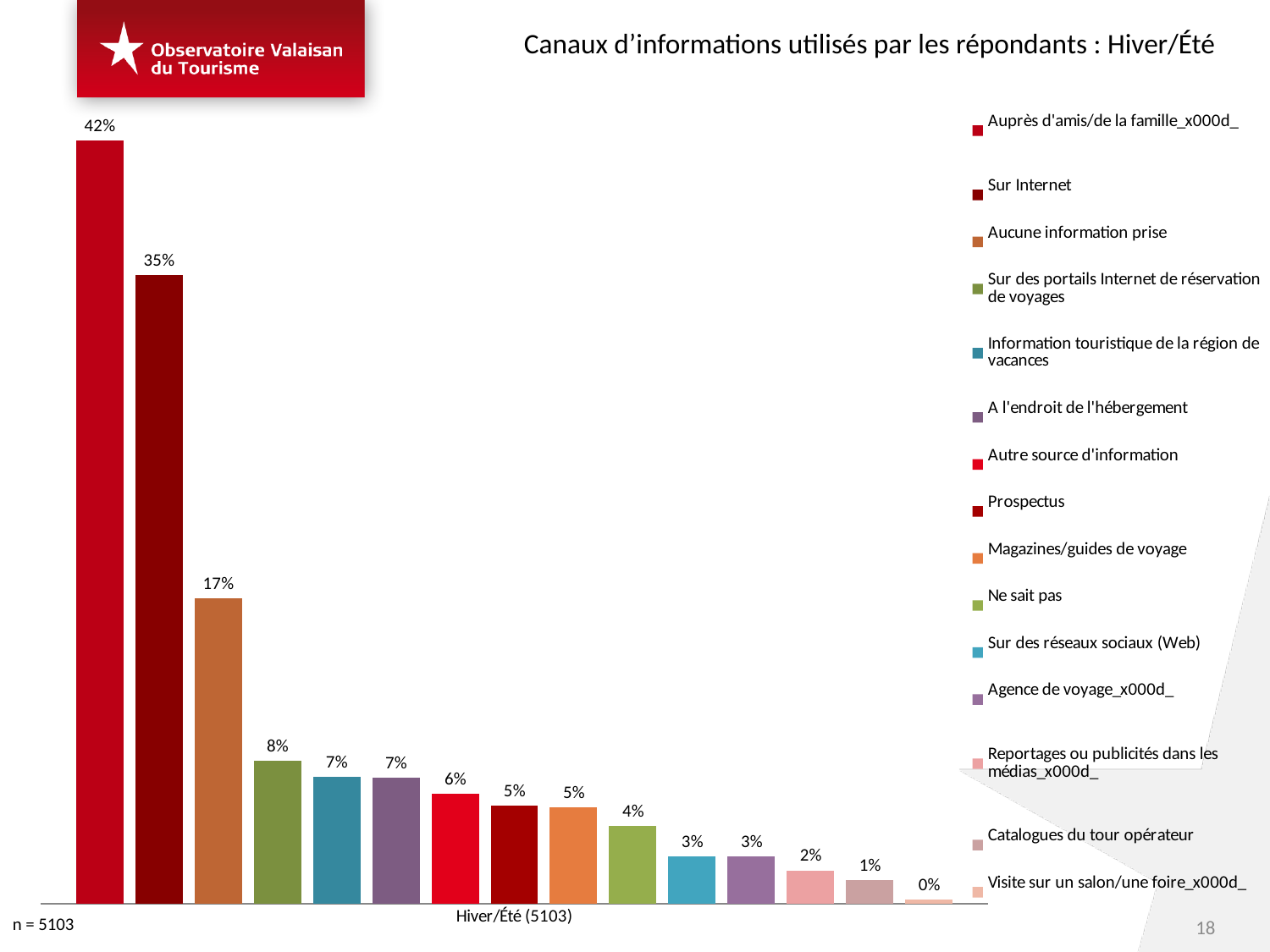
What is the title of the chart? Canaux d'informations utilisés par les répondants : Hiver/Été What kind of chart is shown on the slide? bar chart What is the value for "Sur des réseaux sociaux (Web)"? 3% Which is larger, the value for "Aucune information prise" or the value for "Sur des portails Internet de réservation de voyages"? Aucune information prise What is the label shown on the x axis under the bars? Hiver/Été (5103) How many series does the legend list? 15 What is the value for "Auprès d'amis/de la famille"? 42% Which information channel has the highest value? Auprès d'amis/de la famille What is the difference between the values for "Auprès d'amis/de la famille" and "Sur Internet"? 7% What is the value for "Sur Internet"? 35% What is the value for "Aucune information prise"? 17% Which information channel has the lowest value? Visite sur un salon/une foire